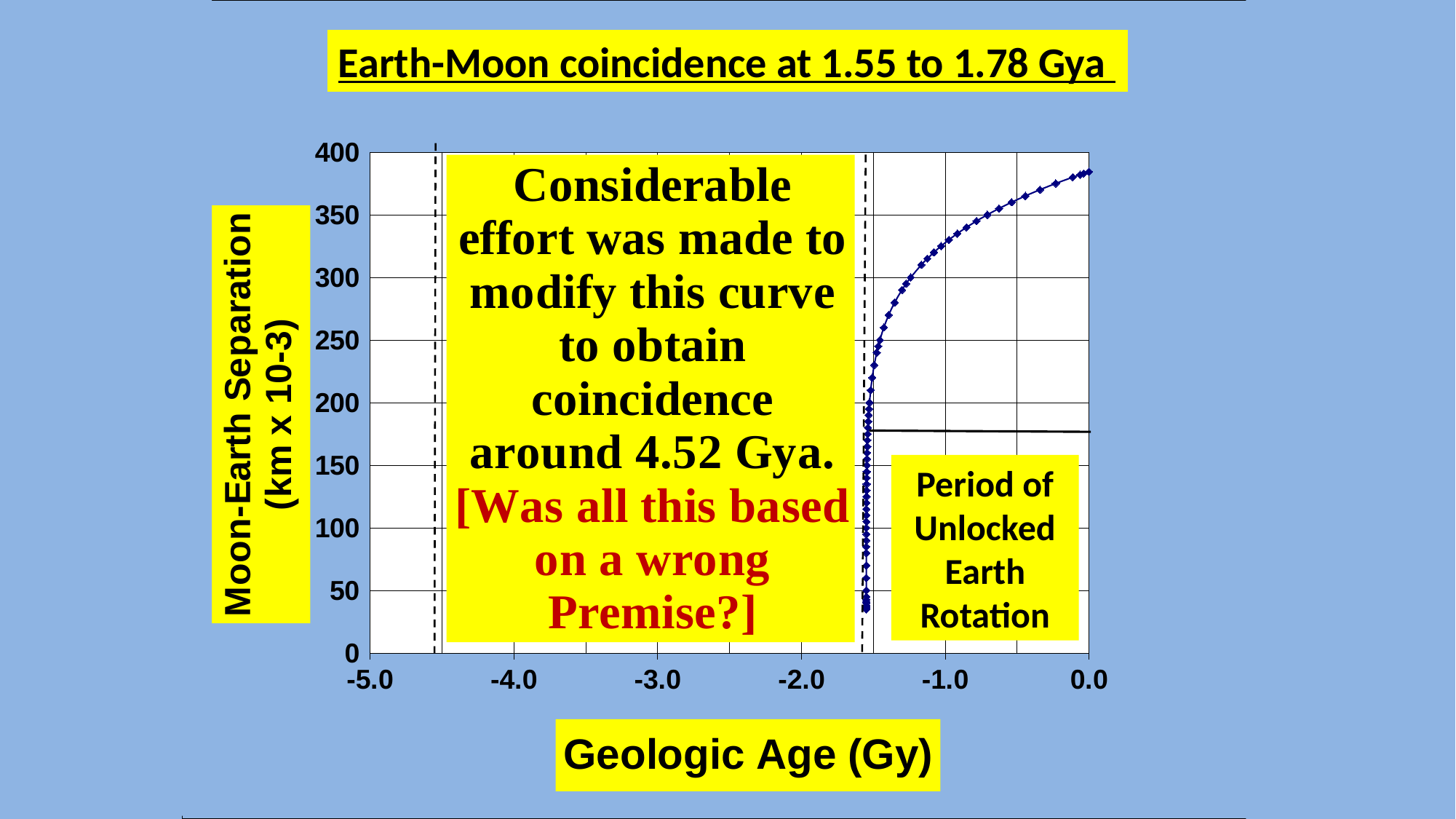
What is the title shown at the top of the slide? Earth-Moon coincidence at 1.55 to 1.78 Gya Is the Moon-Earth separation at geologic age -1.0 greater or less than 400? less Which is larger, the Moon-Earth separation at geologic age -1.0 or at 0.0? 0.0 Is the Moon-Earth separation at geologic age 0.0 greater or less than 350? greater How many tick labels are shown on the horizontal axis? 6 What is the label of the vertical axis of the chart? Moon-Earth Separation (km x 10-3) Which is larger, the Moon-Earth separation at geologic age -1.5 or at -0.5? -0.5 Is the Moon-Earth separation at geologic age -0.5 greater or less than 350? greater At which geologic age does the curve reach its highest Moon-Earth separation? 0.0 As geologic age goes from -1.5 to 0.0 Gy, does the Moon-Earth separation rise or fall? rise What kind of chart is shown on the slide? line chart